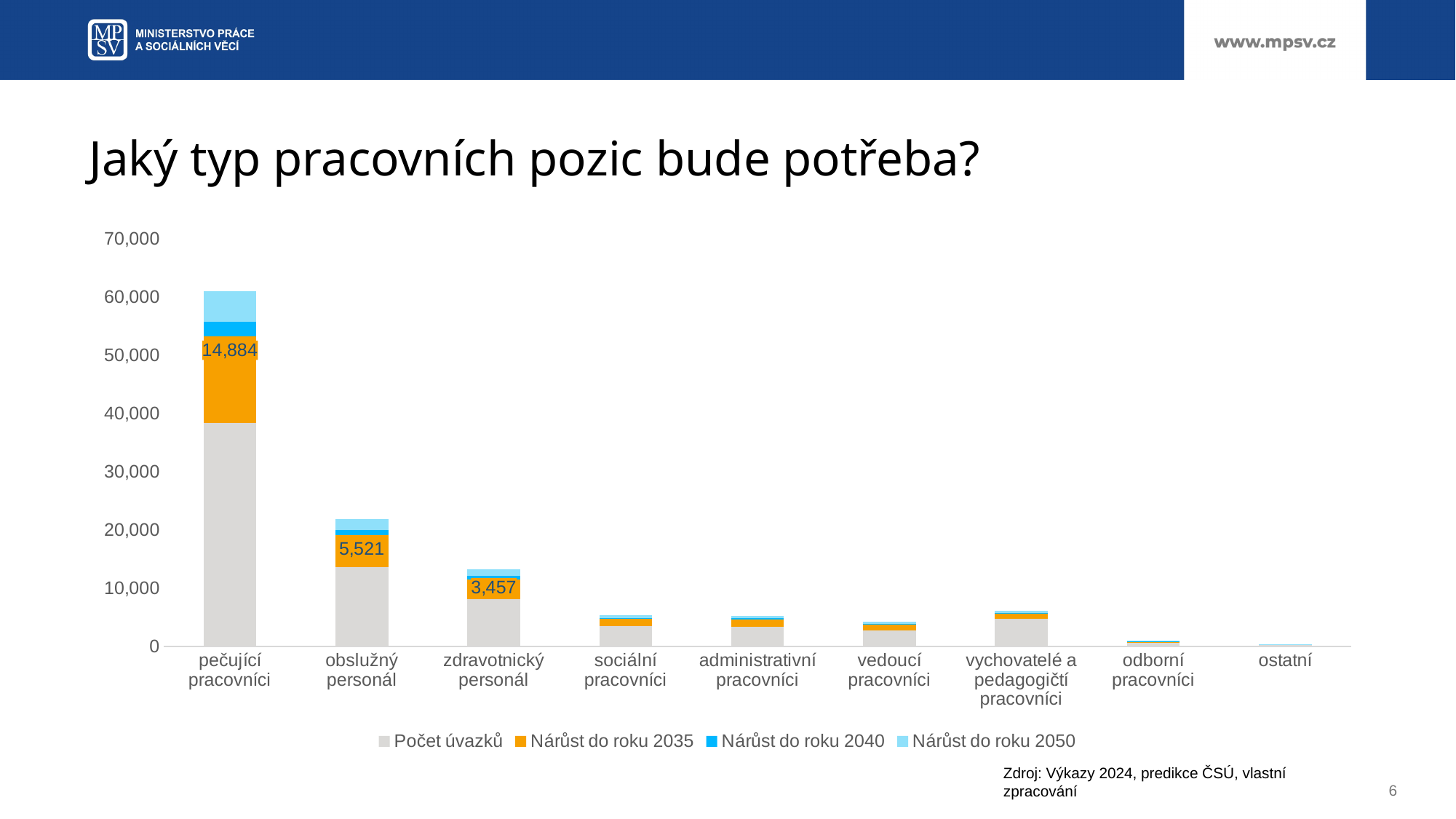
What is the difference between the Nárůst do roku 2035 values for obslužný personál and zdravotnický personál? 2,064 How many categories are shown on the x axis? 9 Is the total stacked value for pečující pracovníci greater or less than 50,000? greater What is the value of the Nárůst do roku 2035 segment for pečující pracovníci? 14,884 Which category has the tallest stacked bar? pečující pracovníci How many series does the legend list? 4 Which category has the shortest stacked bar? ostatní Which stacked bar is taller: obslužný personál or zdravotnický personál? obslužný personál What is the value of the Nárůst do roku 2035 segment for obslužný personál? 5,521 What is the difference between the Nárůst do roku 2035 values for pečující pracovníci and obslužný personál? 9,363 What is the value of the Nárůst do roku 2035 segment for zdravotnický personál? 3,457